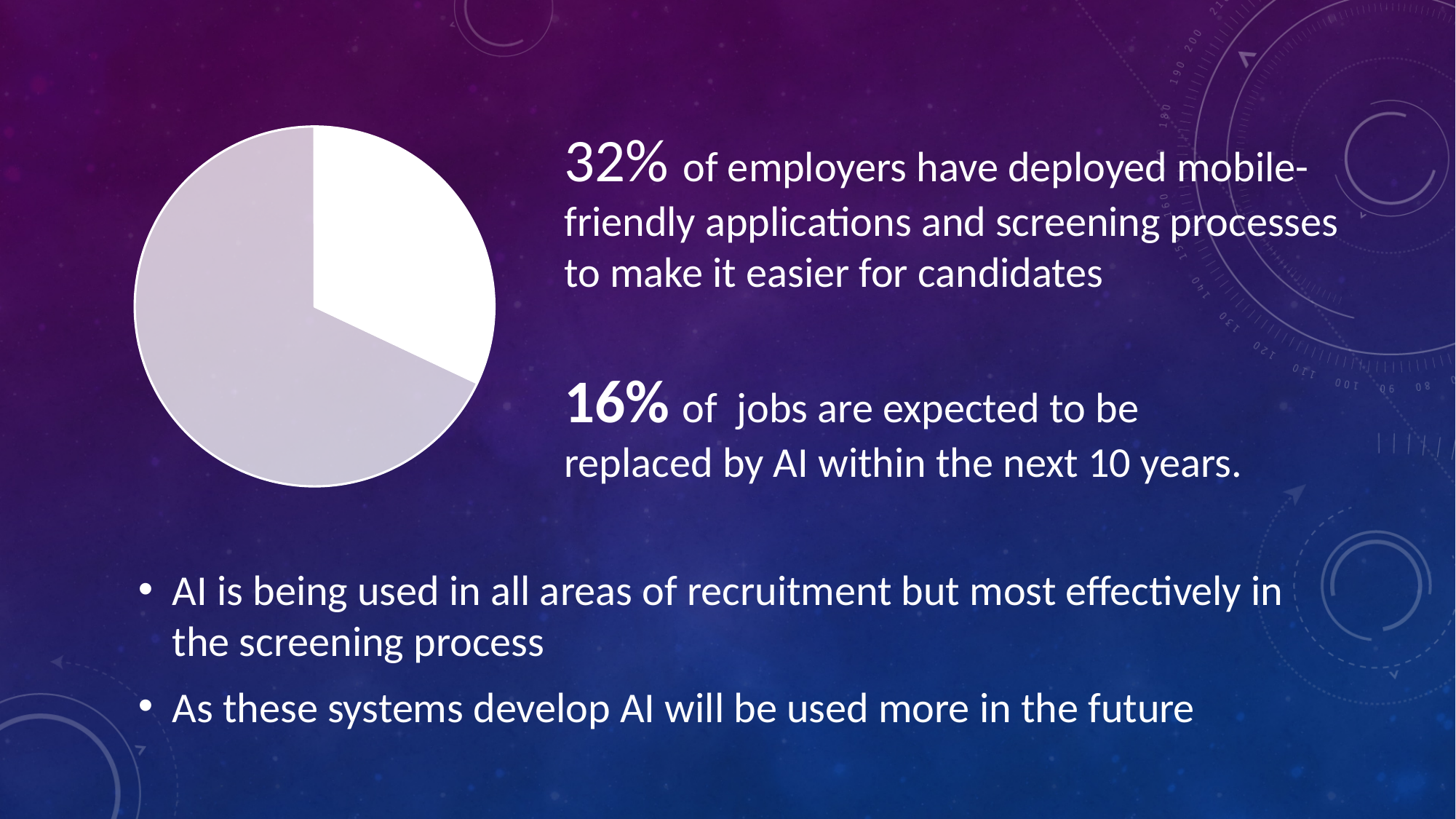
Which slice of the pie chart is larger, the white slice or the grey slice? the grey slice How many slices does the pie chart have? 2 Does the pie chart show data labels on its slices? No Does the pie chart display a legend? No Which slice of the pie chart is the largest? the grey slice What kind of chart is shown on the left of the slide? pie chart Which slice of the pie chart is the smallest? the white slice